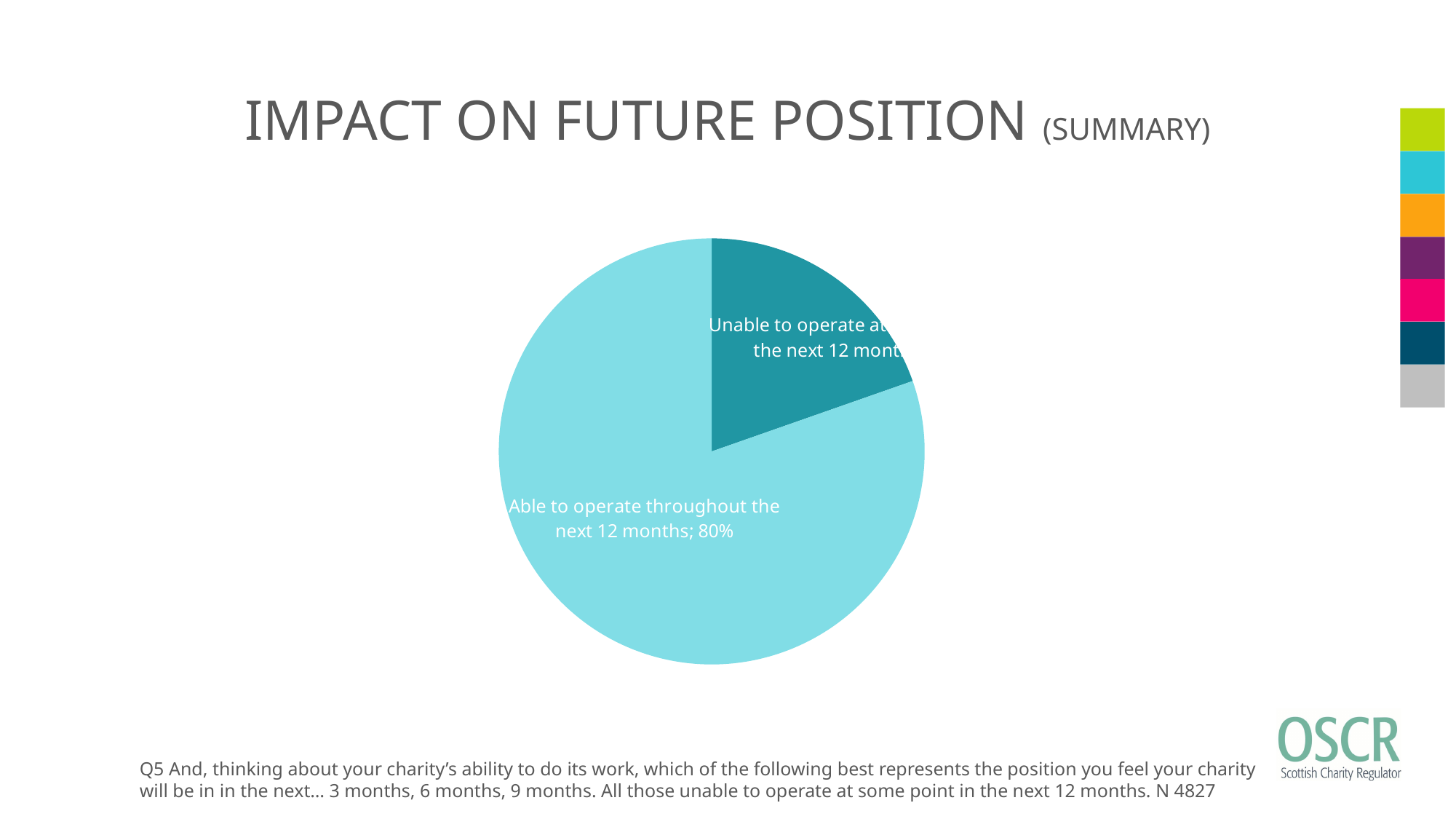
What kind of chart is shown on the slide? Pie chart What share of the pie does the 'Able to operate throughout the next 12 months' slice represent? 80% Is the share of charities able to operate throughout the next 12 months greater or less than 50%? greater What is the title of the slide containing the pie chart? IMPACT ON FUTURE POSITION (SUMMARY) What is the sample size (N) given in the footnote below the chart? 4827 Which is larger: the share able to operate throughout the next 12 months or the share unable to operate at some point in the next 12 months? Able to operate throughout the next 12 months Which slice of the pie chart is the smallest? Unable to operate at some point in the next 12 months How many slices does the pie chart have? 2 Which slice of the pie chart is the largest? Able to operate throughout the next 12 months What percentage of charities said they would be able to operate throughout the next 12 months? 80%